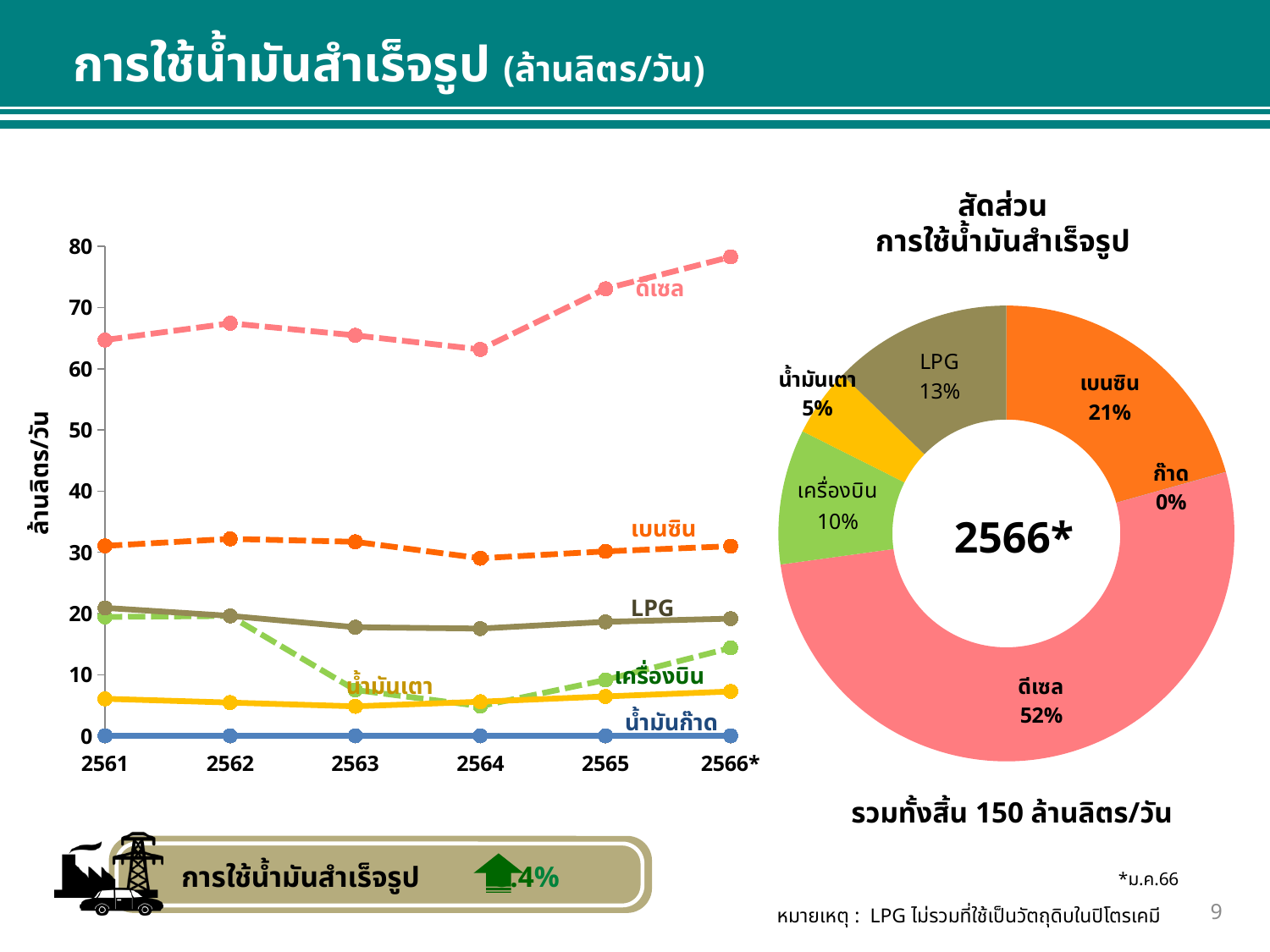
In the donut chart สัดส่วนการใช้น้ำมันสำเร็จรูป, which category has the smallest share? ก๊าด In the donut chart สัดส่วนการใช้น้ำมันสำเร็จรูป, what is the difference between the shares of เบนซิน and เครื่องบิน? 11% In the donut chart สัดส่วนการใช้น้ำมันสำเร็จรูป, what share does LPG have? 13% In the line chart on the left, is the value for ดีเซล in 2566* greater or less than 70? greater In the donut chart สัดส่วนการใช้น้ำมันสำเร็จรูป, which has the larger share, เครื่องบิน or น้ำมันเตา? เครื่องบิน How many categories are shown in the donut chart สัดส่วนการใช้น้ำมันสำเร็จรูป? 6 In the donut chart สัดส่วนการใช้น้ำมันสำเร็จรูป, what share does ดีเซล have? 52% In the donut chart สัดส่วนการใช้น้ำมันสำเร็จรูป, which category has the largest share? ดีเซล What kind of chart is the chart on the left of the slide? Line chart How many series are plotted in the line chart on the left? 6 In the line chart on the left, does the ดีเซล line rise or fall from 2564 to 2566*? rise What kind of chart is the chart on the right of the slide? Donut (pie) chart